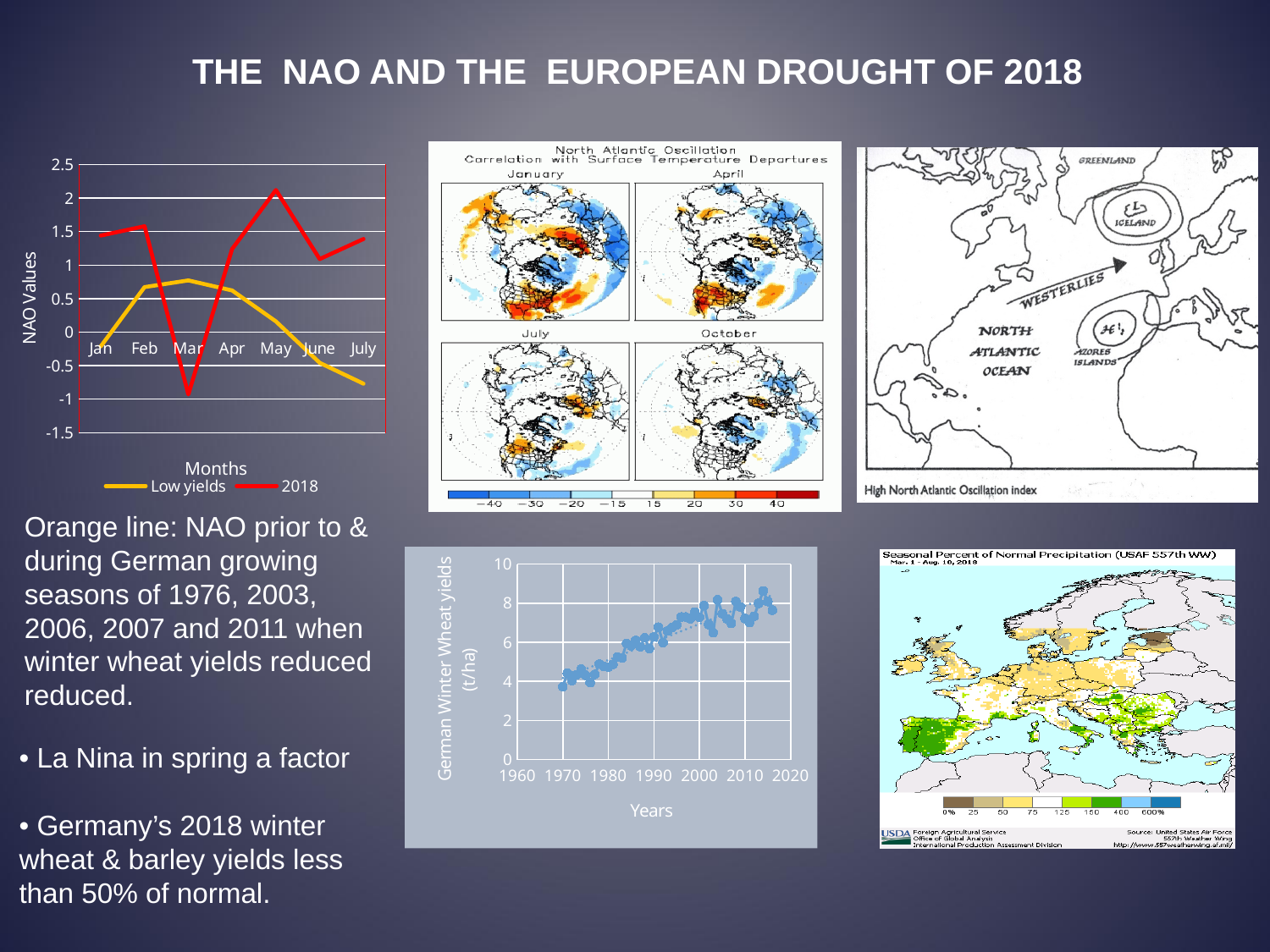
In the NAO Values chart on the left, in which month does the 2018 series reach its highest value? May In the NAO Values chart on the left, in which month does the 2018 series reach its lowest value? Mar In the NAO Values chart on the left, how many series does the legend list? 2 In the NAO Values chart on the left, is the 2018 value for Mar greater or less than -0.5? less In the NAO Values chart on the left, is the Low yields value for Mar greater or less than 0.5? greater In the NAO Values chart on the left, which series has the higher value in Mar, Low yields or 2018? Low yields In the NAO Values chart on the left, in which month is the Low yields series lowest? July In the NAO Values chart on the left, is the 2018 value for May greater or less than 1.5? greater In the German Winter Wheat yields chart at the bottom centre, what is the label of the x axis? Years In the German Winter Wheat yields chart at the bottom centre, do the yields generally rise or fall from 1970 to 2020? rise In the NAO Values chart on the left, how many months are shown on the x axis? 7 In the NAO Values chart on the left, what kind of chart is it? line chart